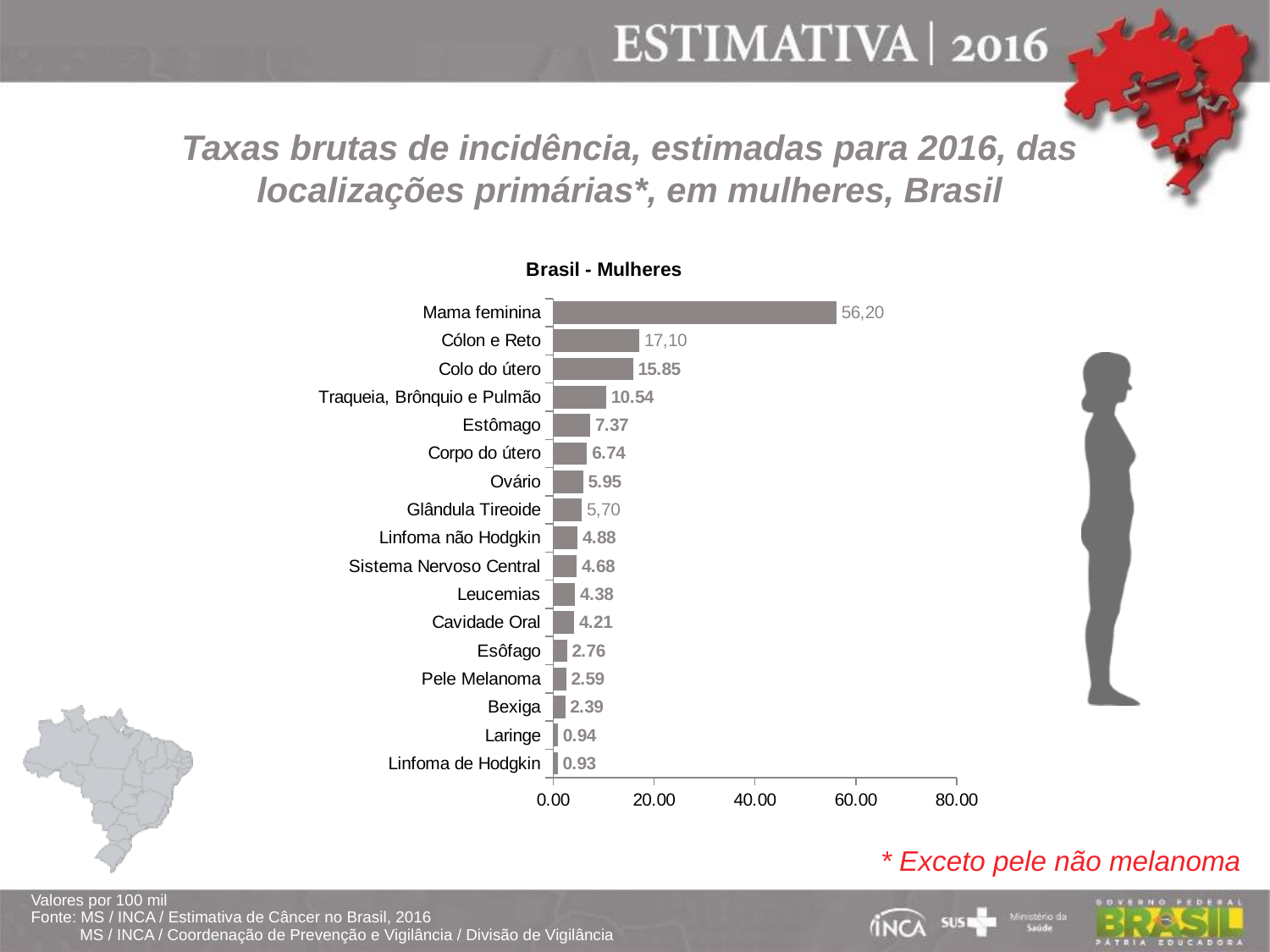
What is the value for Bexiga? 2.39 What kind of chart is shown on the slide? Bar chart How many categories are shown in the chart? 17 What is the value for Glândula Tireoide? 5,70 Which category has the highest value in the chart? Mama feminina What is the difference between the values for Estômago and Corpo do útero? 0.63 What is the value for Traqueia, Brônquio e Pulmão? 10.54 What is the difference between the values for Colo do útero and Traqueia, Brônquio e Pulmão? 5.31 Which category has the lowest value in the chart? Linfoma de Hodgkin What is the value for Mama feminina in the Brasil - Mulheres chart? 56,20 Which has a larger value, Leucemias or Cavidade Oral? Leucemias Is the value for Mama feminina greater or less than 40.00? greater